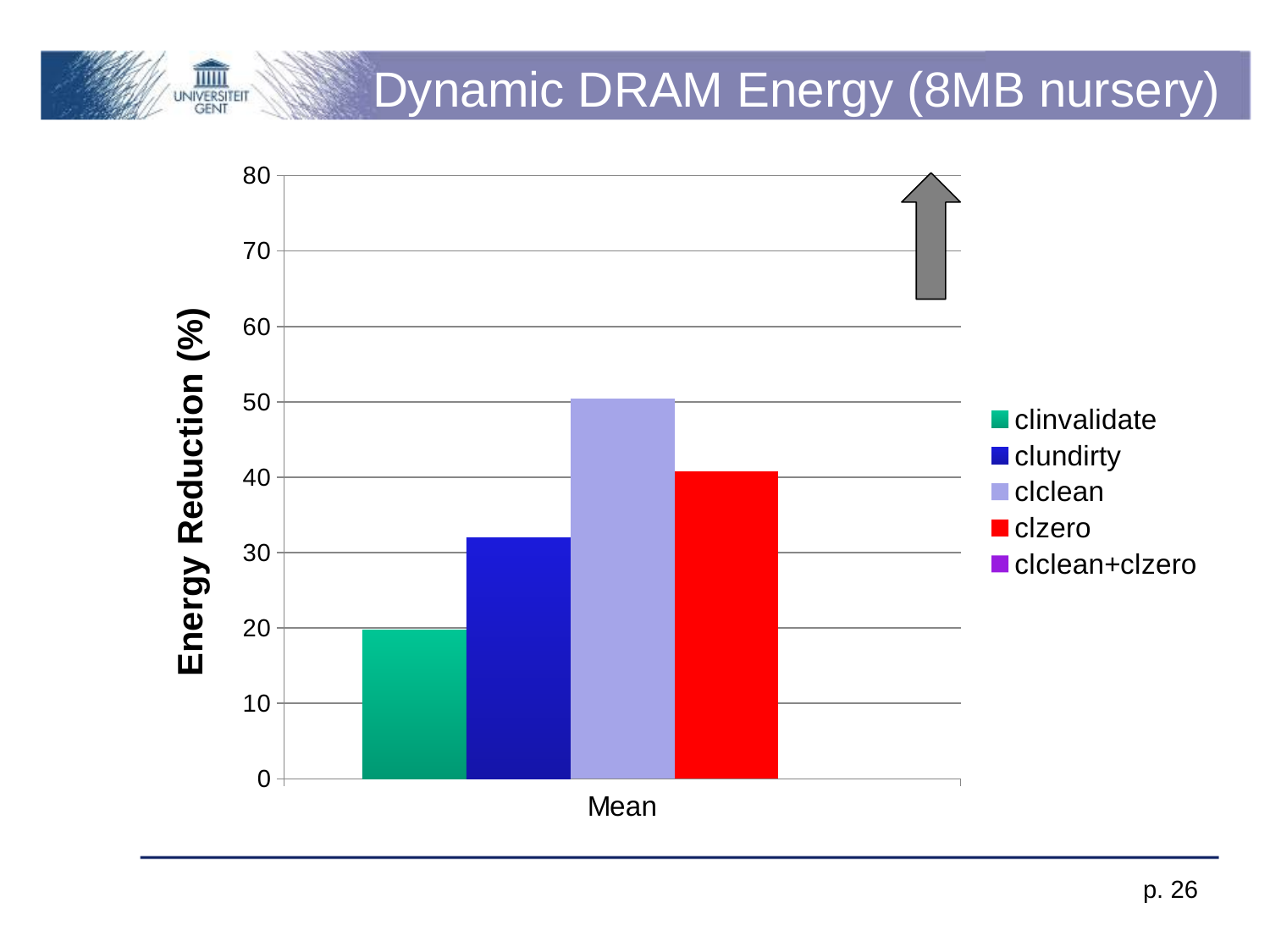
Is the value for clzero greater or less than 50? less Is the value for clundirty greater or less than 40? less How many categories are shown on the x axis? 1 What is the label of the y axis? Energy Reduction (%) How many series does the legend list? 5 Is the value for clinvalidate greater or less than 30? less What kind of chart is shown on the slide? bar chart What is the title of the chart on the slide? Dynamic DRAM Energy (8MB nursery) Which is larger for Mean, the value for clzero or the value for clundirty? clzero Which of the plotted series has the lowest energy reduction for Mean? clinvalidate Which series has the highest energy reduction for Mean? clclean